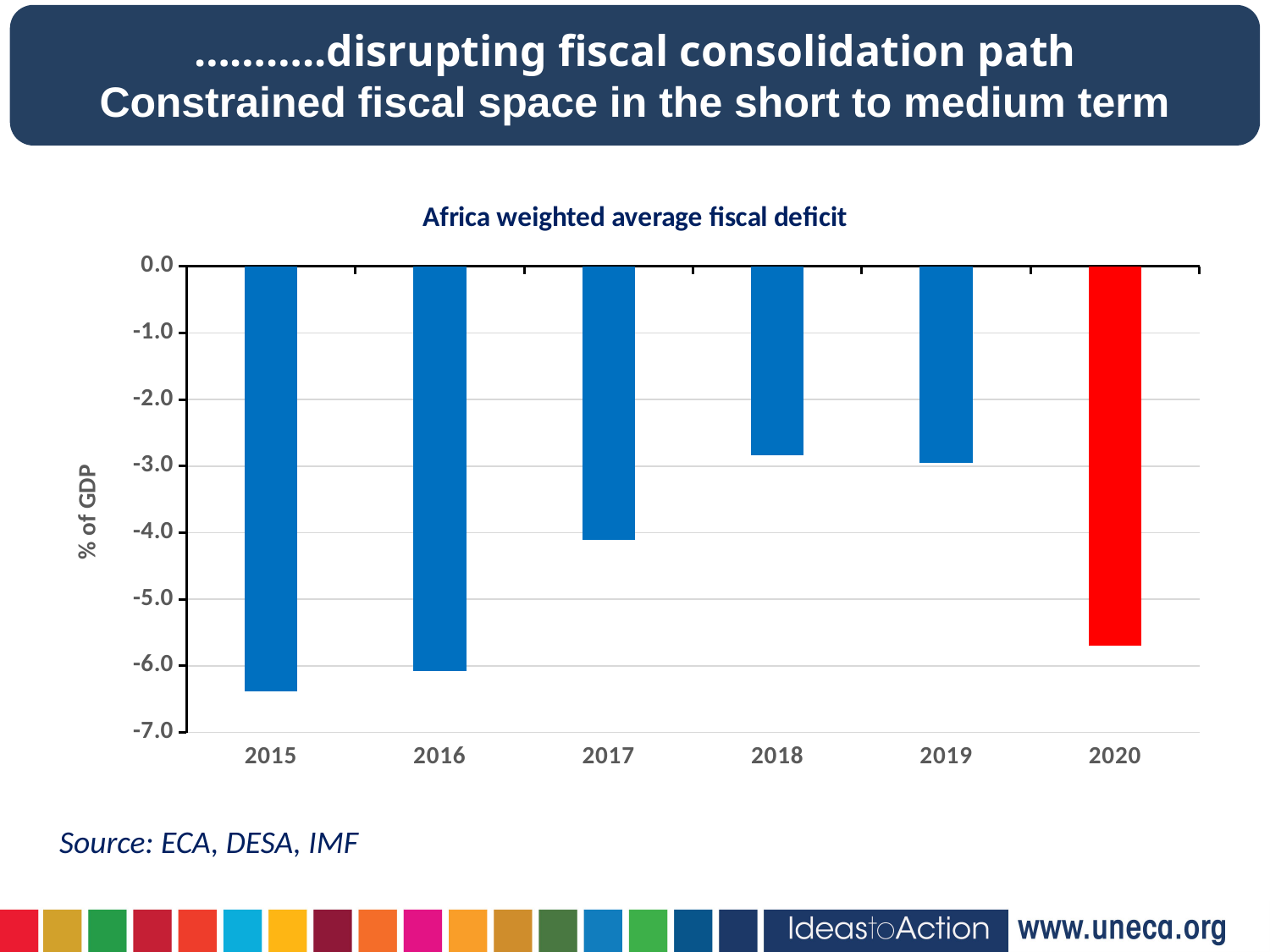
What is the title of the chart? Africa weighted average fiscal deficit Is the value for 2020 greater or less than -6.0? greater Is the value for 2015 greater or less than -6.0? less Is the value for 2018 greater or less than -2.0? less Do the values rise or fall from 2015 to 2018? rise What is the label on the vertical axis of the chart? % of GDP How many years are shown on the x axis of the chart? 6 Which year has the lowest (most negative) value in the chart? 2015 Which year has the larger (less negative) value, 2015 or 2020? 2020 Which year has the larger (less negative) value, 2017 or 2020? 2017 What kind of chart is shown on the slide? bar chart